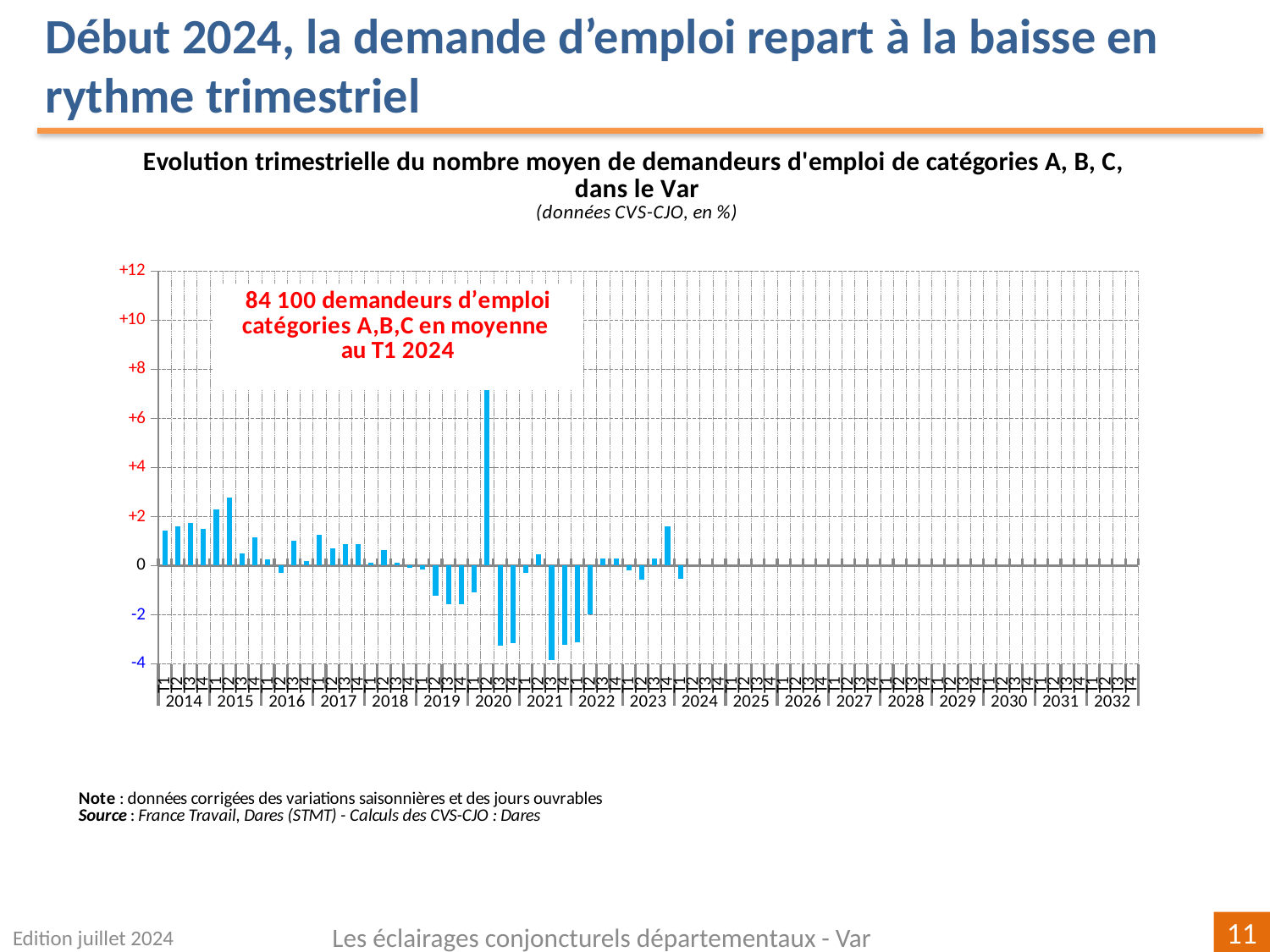
Is the value for T2 2015 greater or less than +2? greater Which quarter has the highest value in the chart? T2 2020 Is the value for T1 2014 greater or less than +2? less Is the value for T1 2024 greater or less than 0? less Which is larger, the value for T2 2020 or the value for T2 2015? T2 2020 Which is larger, the value for T4 2023 or the value for T1 2024? T4 2023 What is the highest value shown on the vertical axis of the chart? +12 Between T4 2023 and T1 2024, does the value rise or fall? fall According to the annotation on the chart, what was the average number of job seekers in categories A, B, C in T1 2024? 84 100 What kind of chart is shown on the slide? bar chart